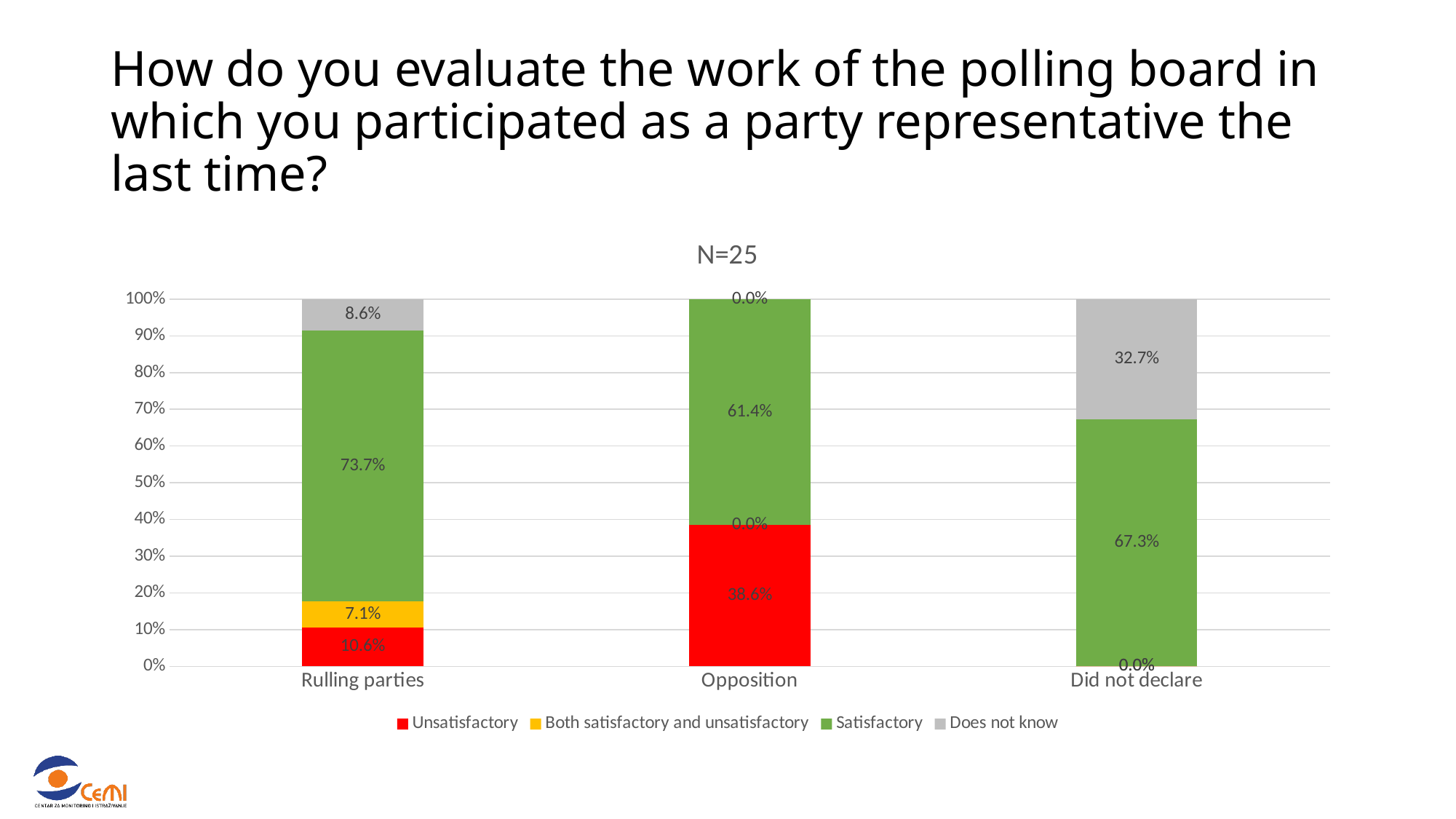
What is the Does not know value for Did not declare? 32.7% Which category has the highest Unsatisfactory value? Opposition What is the Satisfactory value for Rulling parties? 73.7% Which category has the highest Satisfactory value? Rulling parties What kind of chart is shown on the slide? Stacked bar chart How many series does the legend list? 4 How many categories are shown on the x axis? 3 What is the difference between the Satisfactory values for Rulling parties and Did not declare? 6.4% Which is larger: the Does not know value for Did not declare or for Rulling parties? Did not declare What is the Unsatisfactory value for Opposition? 38.6% What is the Satisfactory value for Opposition? 61.4% What is the Both satisfactory and unsatisfactory value for Rulling parties? 7.1%